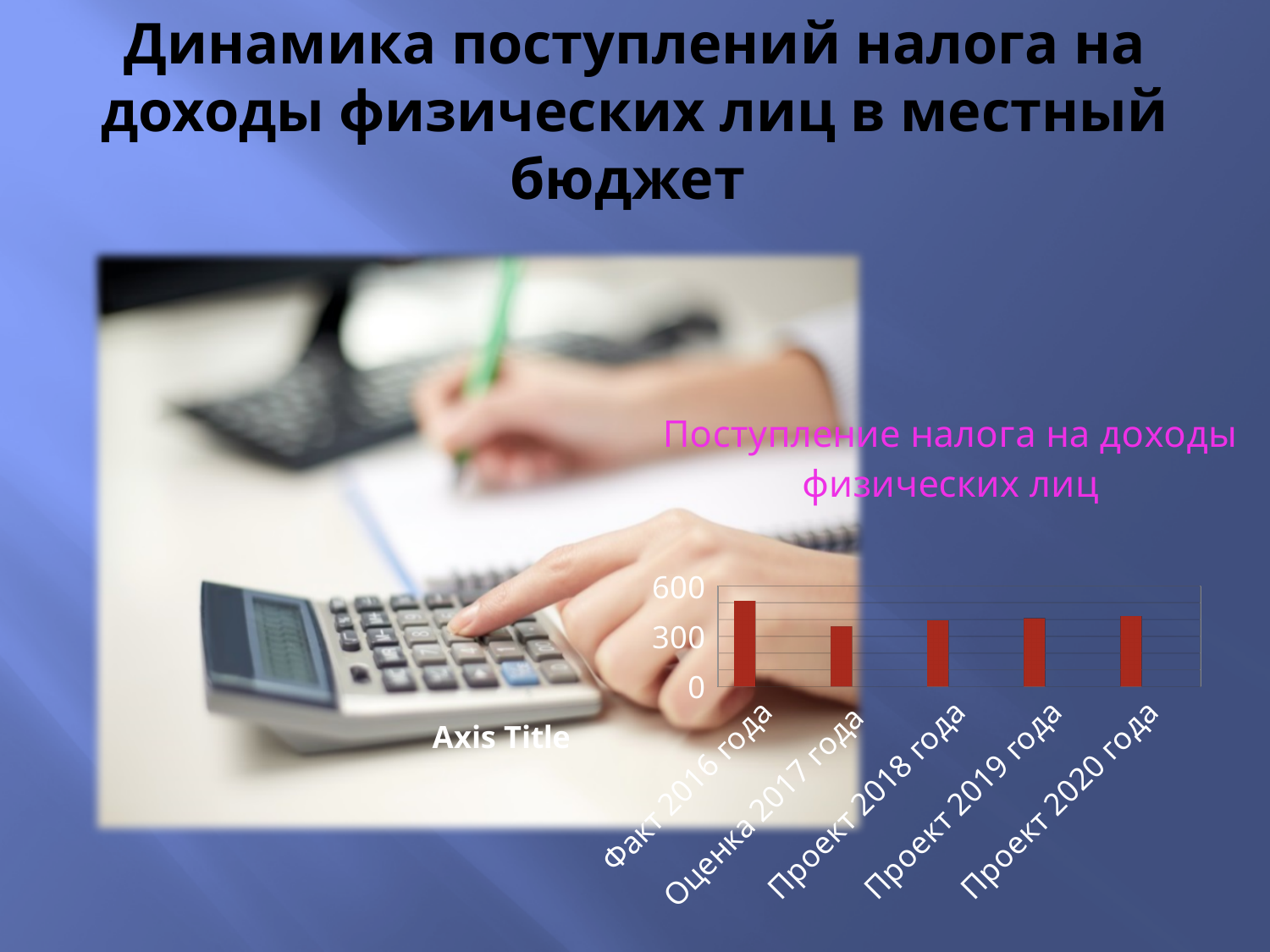
Which is larger, the value for Факт 2016 года or the value for Оценка 2017 года? Факт 2016 года Is the value for Проект 2020 года greater or less than 300? greater What kind of chart is shown on the slide? bar chart Is the value for Факт 2016 года greater or less than 300? greater What text is shown as the horizontal axis title of the chart? Axis Title Do the values rise or fall from Оценка 2017 года to Проект 2020 года? rise What is the title of the chart? Поступление налога на доходы физических лиц Which is larger, the value for Оценка 2017 года or the value for Проект 2020 года? Проект 2020 года Which category has the highest bar in the chart? Факт 2016 года How many categories are shown on the x axis of the chart? 5 Which category has the lowest bar in the chart? Оценка 2017 года Is the value for Факт 2016 года greater or less than 600? less